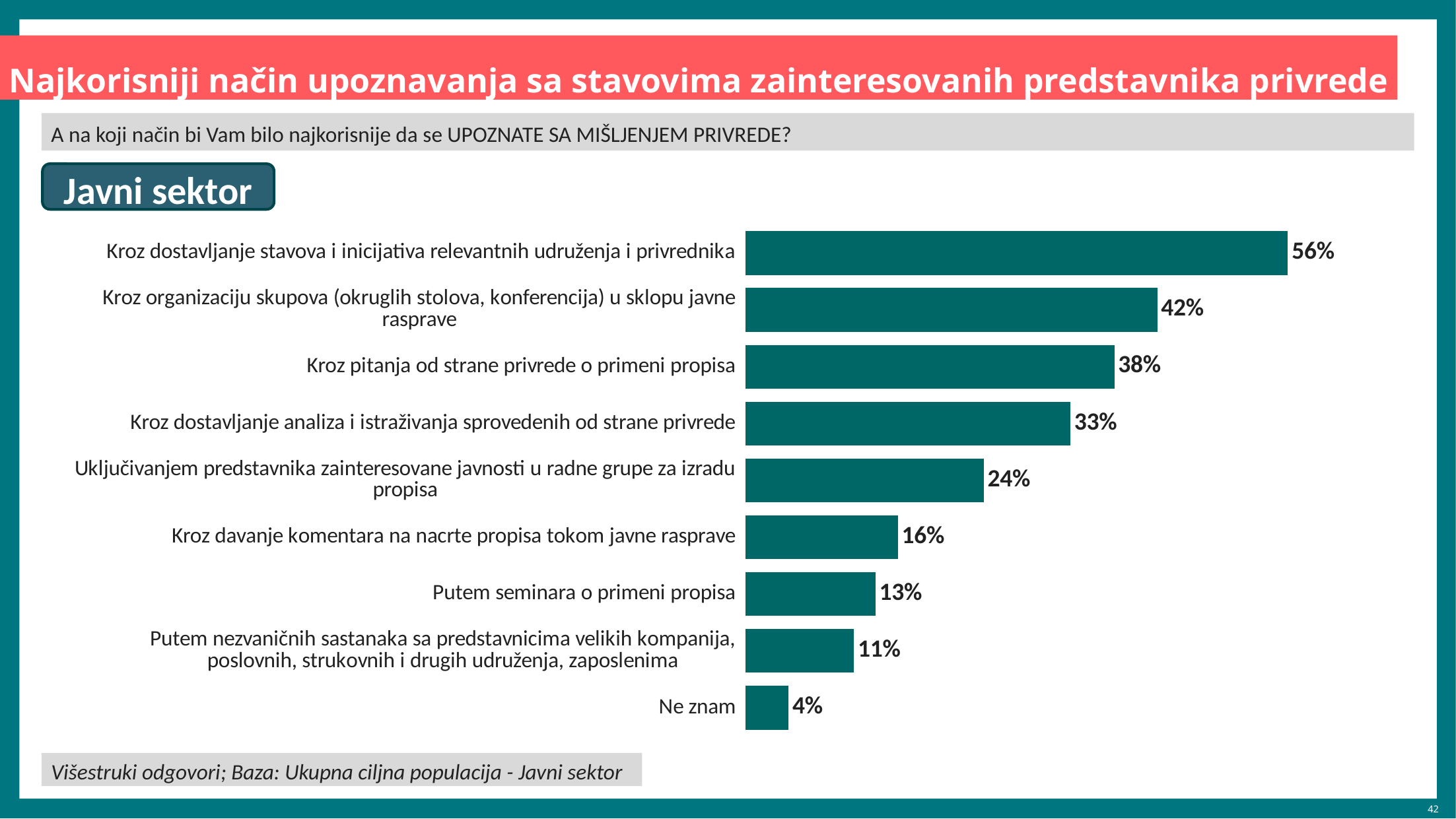
What kind of chart is shown on the slide? Bar chart Which is larger: the value for "Kroz davanje komentara na nacrte propisa tokom javne rasprave" or the value for "Putem seminara o primeni propisa"? Kroz davanje komentara na nacrte propisa tokom javne rasprave What is the value for "Kroz dostavljanje stavova i inicijativa relevantnih udruženja i privrednika"? 56% Which sector label is shown above the chart? Javni sektor What is the difference between the highest and lowest values in the chart? 52% Which category has the lowest value? Ne znam How many categories are shown in the chart? 9 What is the value for "Ne znam"? 4% Which category has the highest value? Kroz dostavljanje stavova i inicijativa relevantnih udruženja i privrednika What is the difference between the values for "Kroz organizaciju skupova (okruglih stolova, konferencija) u sklopu javne rasprave" and "Kroz pitanja od strane privrede o primeni propisa"? 4% What is the value for "Putem seminara o primeni propisa"? 13% What is the value for "Kroz pitanja od strane privrede o primeni propisa"? 38%